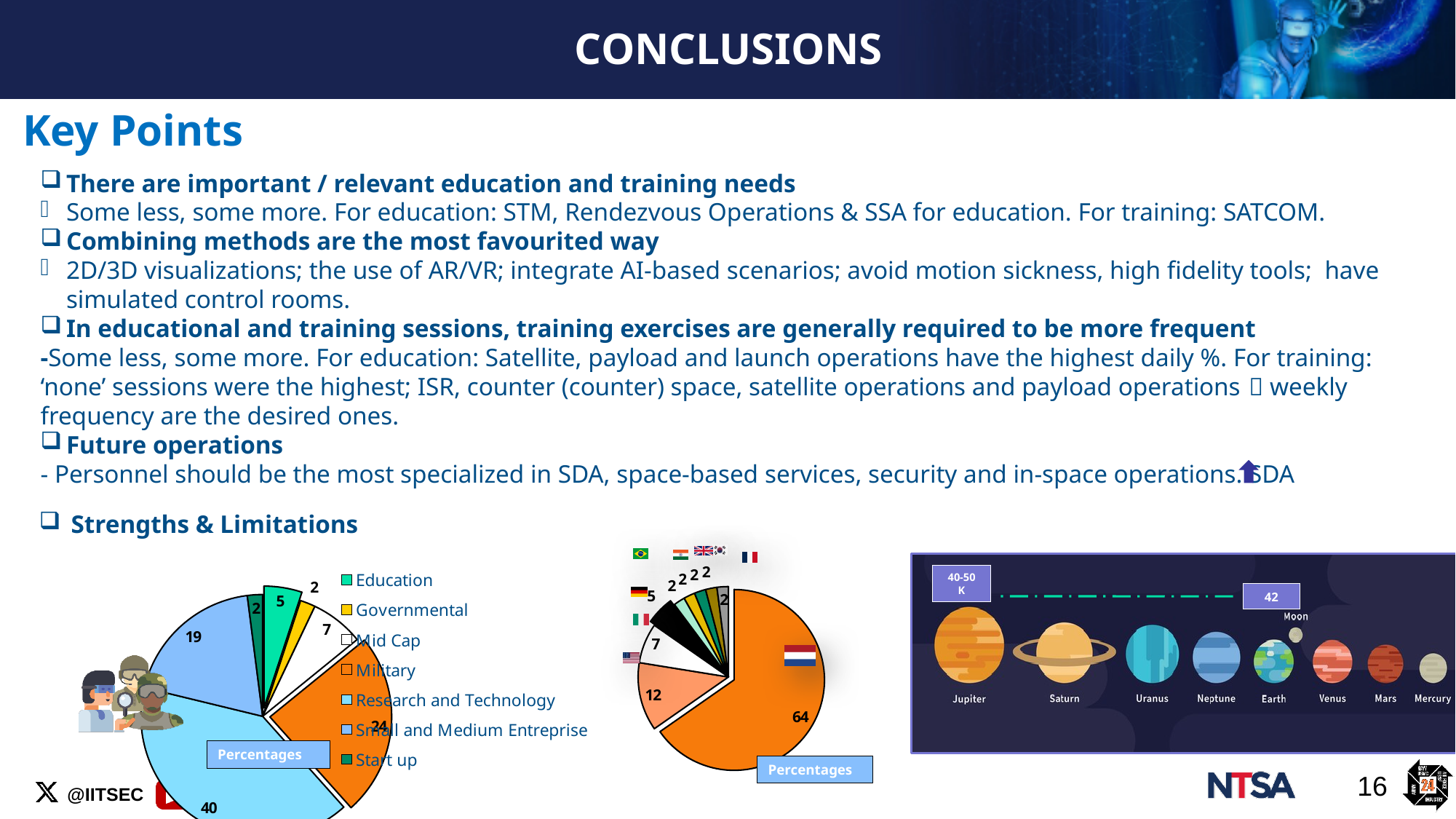
In the left pie chart, which category has the largest slice? Research and Technology How many slices does the right pie chart with the country flags have? 9 How many entries does the legend of the left pie chart list? 7 In the left pie chart, which is larger, Mid Cap or Education? Mid Cap In the left pie chart, what is the difference between the Research and Technology value and the Military value? 16 In the right pie chart with the country flags, what is the difference between the largest slice (64) and the second largest slice (12)? 52 In the left pie chart, what is the value for Research and Technology? 40 In the left pie chart, what is the value for Military? 24 In the right pie chart with the country flags, what is the value of the largest slice? 64 What label appears in the blue box below each pie chart? Percentages What kind of chart is the left chart with the Education/Governmental legend? pie chart In the left pie chart, what is the value for Small and Medium Entreprise? 19